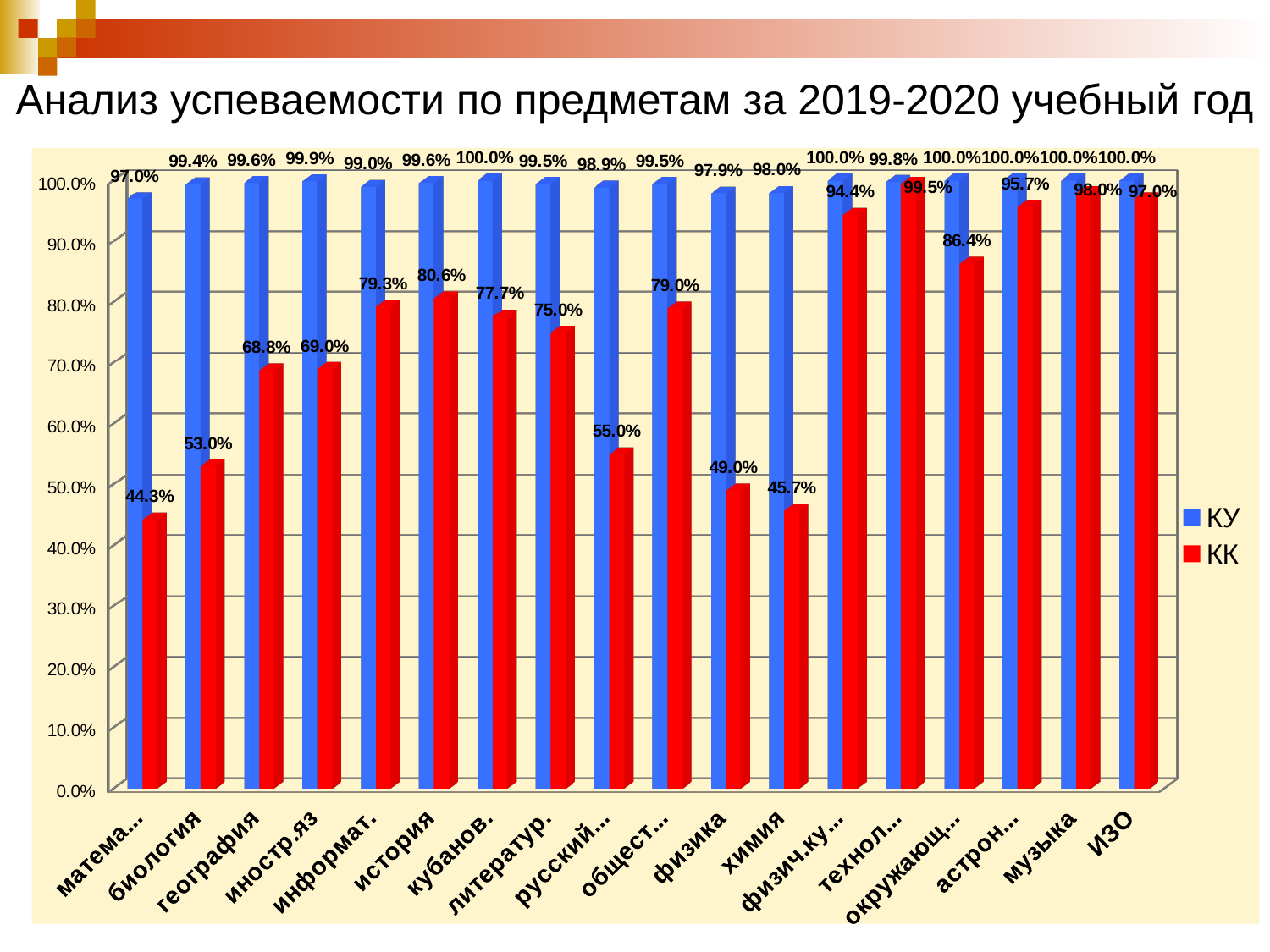
Is the КК value for музыка greater or less than 90.0%? greater What is the КК value for история? 80.6% Which category has the lowest КК value? матема... How many series does the legend list? 2 What is the КК value for биология? 53.0% What kind of chart is shown on the slide? bar chart What is the КК value for ИЗО? 97.0% How many categories are shown on the x axis? 18 Which category has the lowest КУ value? матема... Which is larger, the КК value for география or the КК value for иностр.яз? иностр.яз What is the difference between the КУ and КК values for химия? 52.3% What is the КУ value for физика? 97.9%